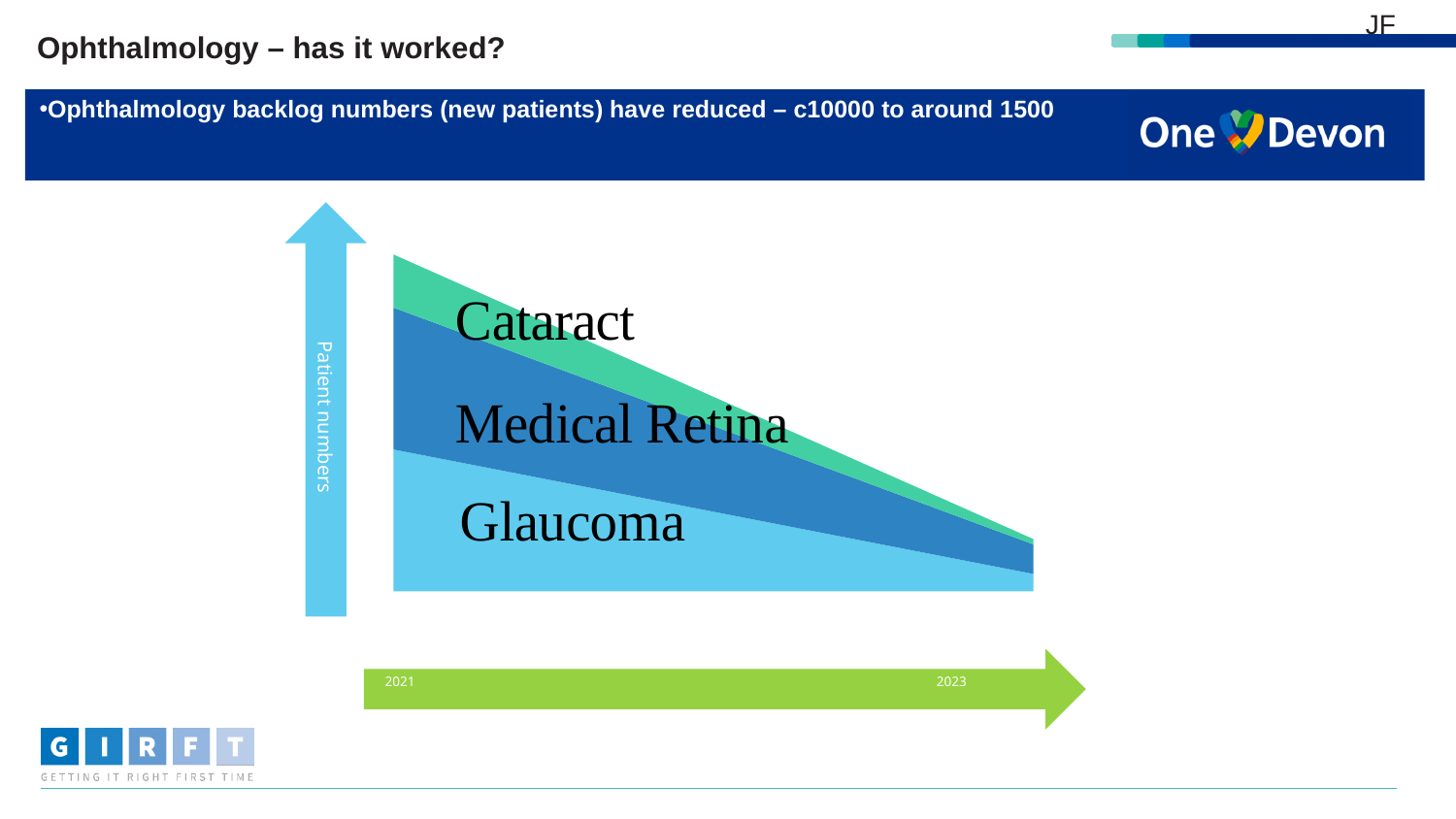
What are the two years labelled on the x axis? 2021 and 2023 Is the total patient number larger in 2021 or in 2023? 2021 What is the last year shown on the x axis? 2023 What kind of chart is shown on the slide? Stacked area chart What is the first year shown on the x axis? 2021 Which conditions are labelled in the chart? Cataract, Medical Retina, Glaucoma Do the patient numbers rise or fall from 2021 to 2023? Fall What is the label on the vertical axis? Patient numbers Which condition is shown in the middle (dark blue) band of the chart? Medical Retina How many categories (conditions) are shown in the chart? 3 Which condition is shown in the top (green) band of the chart? Cataract Which condition is shown in the bottom (light blue) band of the chart? Glaucoma